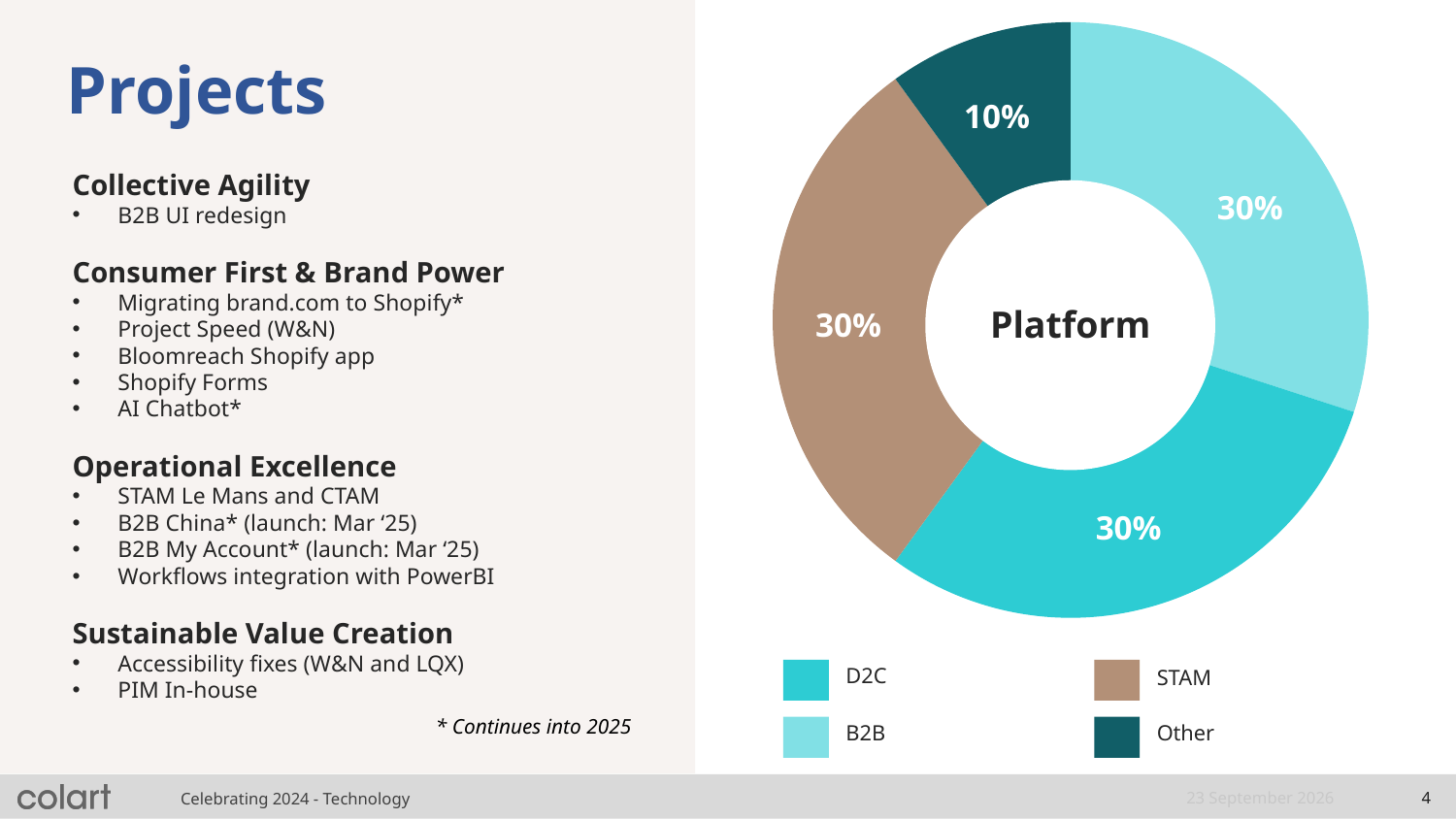
How many categories are shown in the Platform chart? 4 What is the difference in percentage points between the B2B slice and the Other slice? 20 Which is larger in the Platform chart, D2C or Other? D2C What type of chart is shown on the slide? Pie (donut) chart What is the title shown in the centre of the chart? Platform What percentage does the Other slice represent in the Platform chart? 10% What is the value shown for D2C in the Platform chart? 30% What is the value shown for STAM in the Platform chart? 30% What share of the Platform chart is labelled B2B? 30% Which legend entry is shown in the tan/brown colour? STAM How many entries does the legend of the Platform chart list? 4 Which category has the smallest slice in the Platform chart? Other